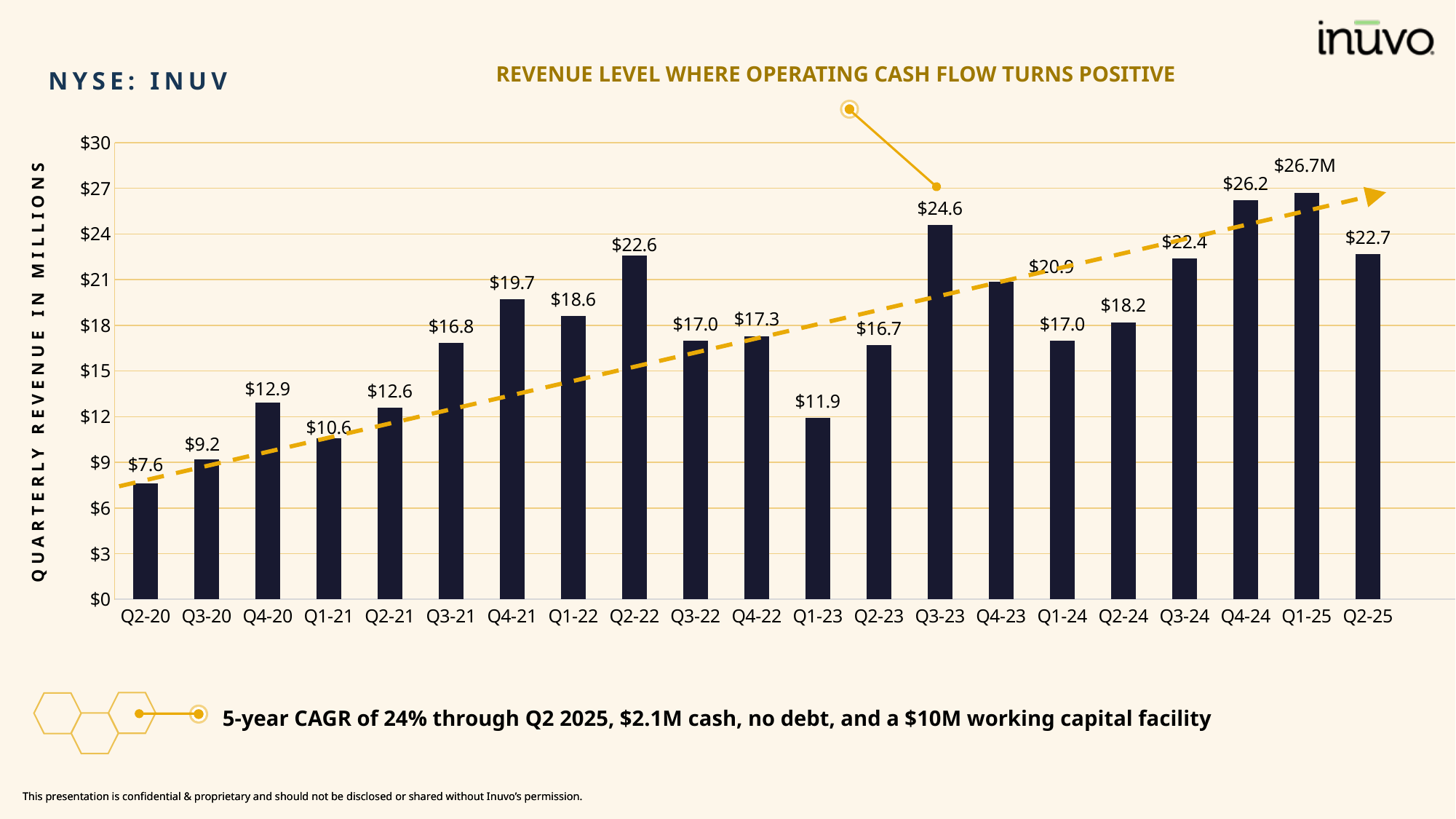
Which quarter has higher revenue, Q2-22 or Q1-23? Q2-22 What is the difference in revenue between Q4-24 and Q3-24? $3.8 What is the quarterly revenue for Q3-23? $24.6 What is the label of the y axis? Quarterly Revenue in Millions How many quarters are shown on the x axis? 21 What kind of chart is shown on the slide? Bar chart What is the quarterly revenue for Q2-25? $22.7 What is the quarterly revenue for Q2-20? $7.6 Which quarter has the lowest revenue? Q2-20 Which quarter has the highest revenue? Q1-25 What is the difference in revenue between Q3-23 and Q2-23? $7.9 What is the quarterly revenue for Q1-25? $26.7M